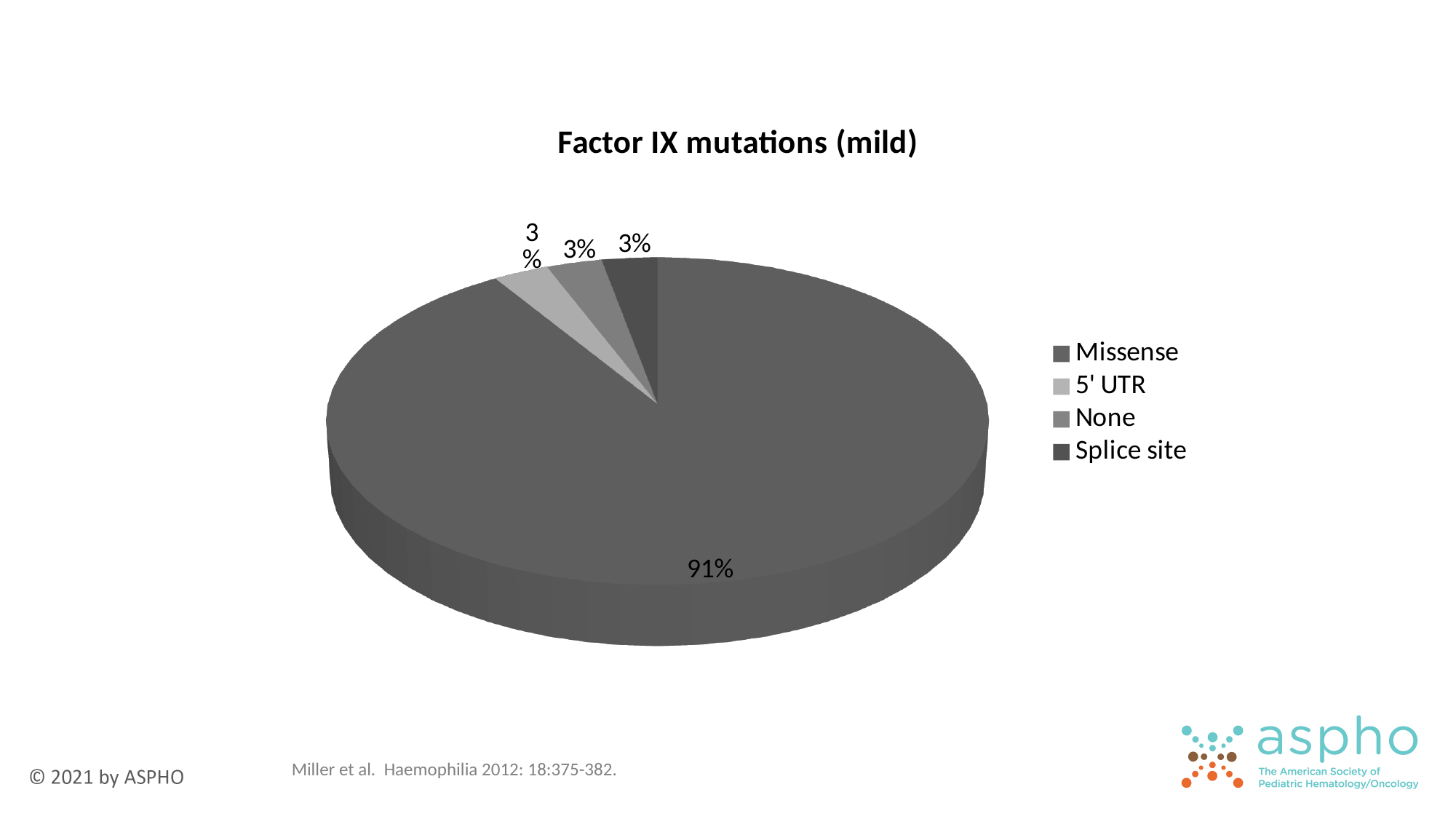
What share of the pie does None account for? 3% What is the difference between the Missense share and the Splice site share? 88% What share of the pie does Splice site account for? 3% How many categories does the legend list? 4 What kind of chart is shown on the slide? pie chart What share of the pie does 5' UTR account for? 3% Which is larger, the Missense slice or the None slice? Missense What is the title of the chart? Factor IX mutations (mild) Which category has the largest slice of the pie? Missense Which category is shown with the lightest shade in the legend? 5' UTR